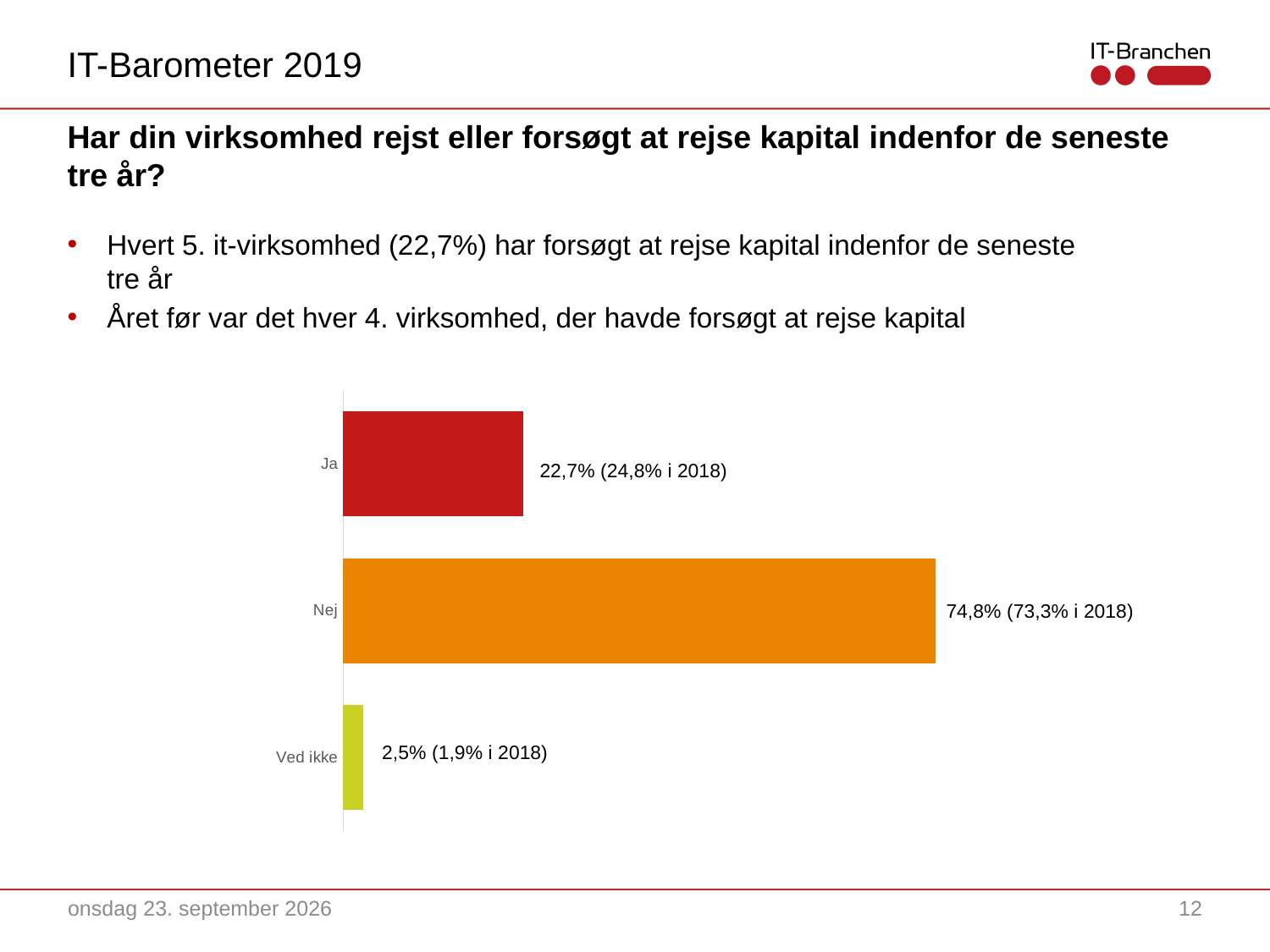
Which is larger, the value for "Ja" or the value for "Ved ikke"? Ja What kind of chart is shown on the slide? Bar chart What is the difference between the values for "Nej" and "Ja"? 52,1 percentage points According to the data label, what was the 2018 value for "Ved ikke"? 1,9% Which category has the highest value in the bar chart? Nej What is the value shown for "Nej" in the bar chart? 74,8% What is the value shown for "Ja" in the bar chart? 22,7% What is the value shown for "Ved ikke" in the bar chart? 2,5% How many categories are shown in the bar chart? 3 According to the data label, what was the 2018 value for "Nej"? 73,3% Which category has the lowest value in the bar chart? Ved ikke According to the data label, what was the 2018 value for "Ja"? 24,8%